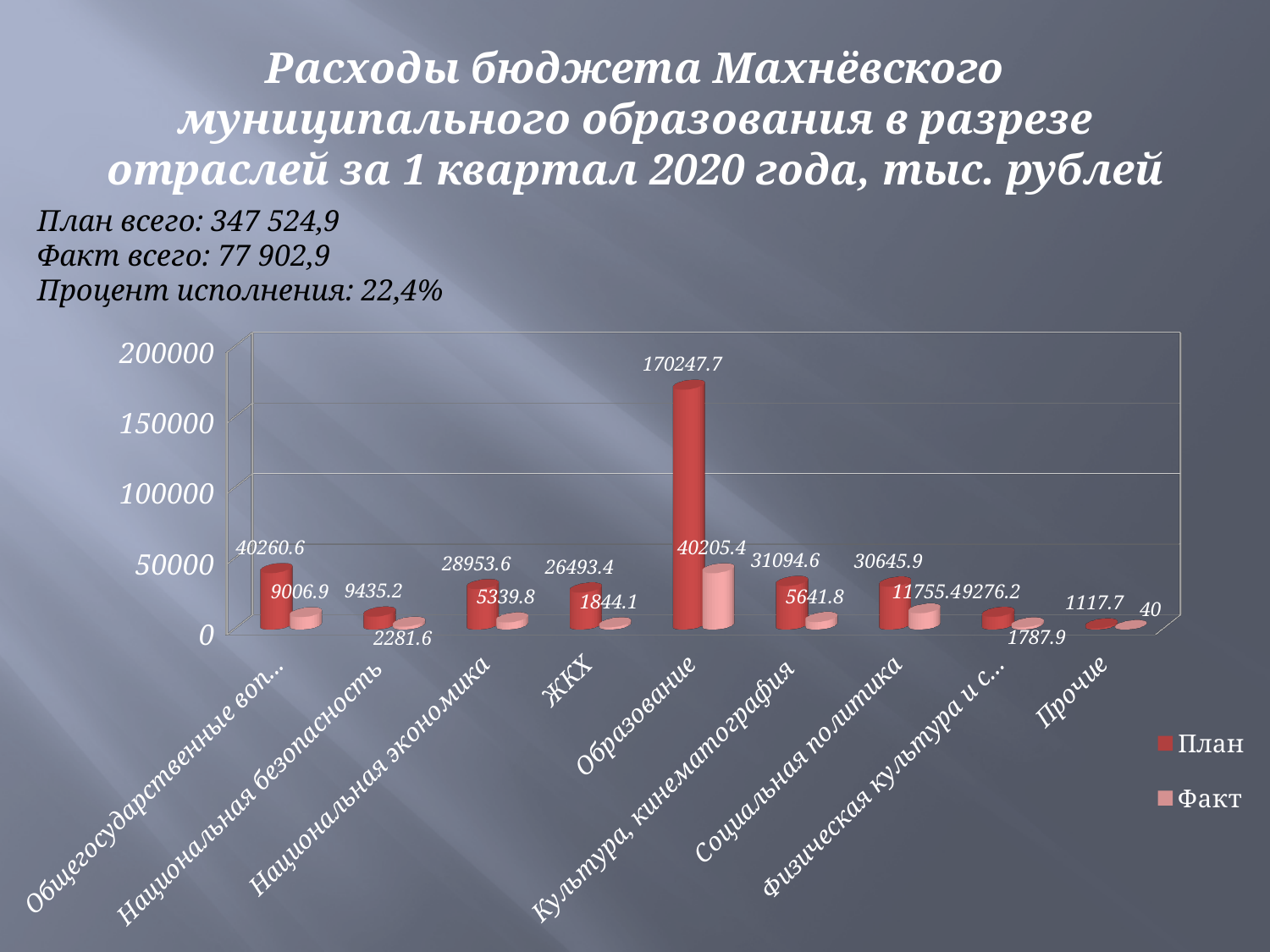
What is the План value for Национальная безопасность? 9435.2 What is the difference between the План and Факт values for Образование? 130042.3 Which is larger: the Факт value for Социальная политика or the Факт value for Общегосударственные воп...? Социальная политика Which category has the lowest Факт value? Прочие What is the Факт value for Социальная политика? 11755.4 What is the difference between the План and Факт values for Прочие? 1077.7 Is the План value for Образование greater or less than 150000? greater How many series does the legend list? 2 What is the План value for Образование? 170247.7 Which category has the highest План value? Образование How many categories are shown on the x axis? 9 What is the Факт value for ЖКХ? 1844.1